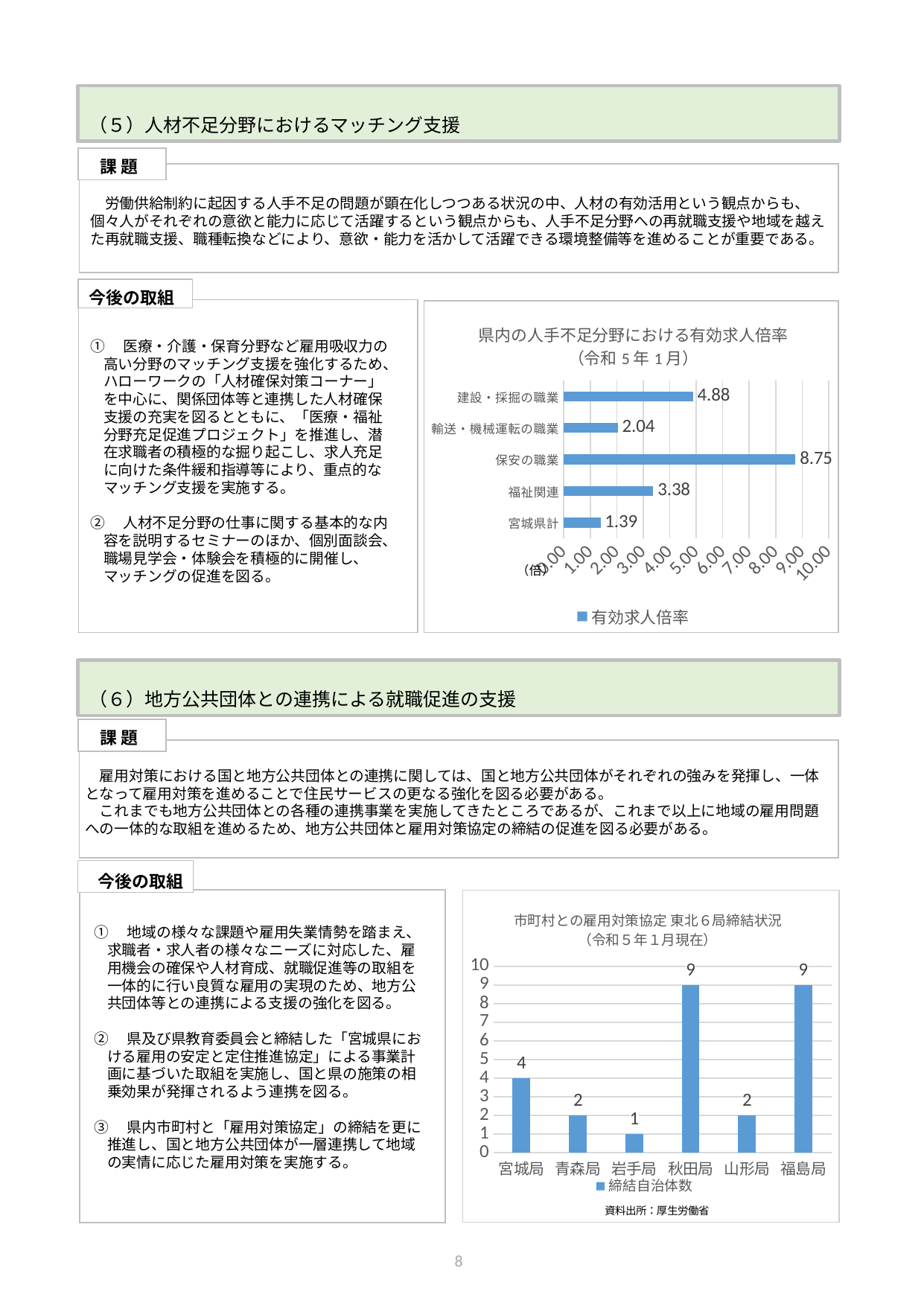
In the chart titled 県内の人手不足分野における有効求人倍率, which category has the highest value? 保安の職業 In the chart titled 県内の人手不足分野における有効求人倍率, how many categories are plotted? 5 In the chart titled 県内の人手不足分野における有効求人倍率, what is the value for 保安の職業? 8.75 In the chart titled 市町村との雇用対策協定 東北６局締結状況, what is the difference between 秋田局 and 青森局? 7 In the chart titled 市町村との雇用対策協定 東北６局締結状況, what is the legend entry? 締結自治体数 In the chart titled 市町村との雇用対策協定 東北６局締結状況, which is larger, 宮城局 or 山形局? 宮城局 In the chart titled 市町村との雇用対策協定 東北６局締結状況, which category has the lowest value? 岩手局 In the chart titled 県内の人手不足分野における有効求人倍率, what is the difference between 建設・採掘の職業 and 福祉関連? 1.50 In the chart titled 県内の人手不足分野における有効求人倍率, what is the value for 宮城県計? 1.39 In the chart titled 県内の人手不足分野における有効求人倍率, which category has the lowest value? 宮城県計 In the chart titled 市町村との雇用対策協定 東北６局締結状況, what is the value for 宮城局? 4 What kind of chart is the one titled 県内の人手不足分野における有効求人倍率? Bar chart